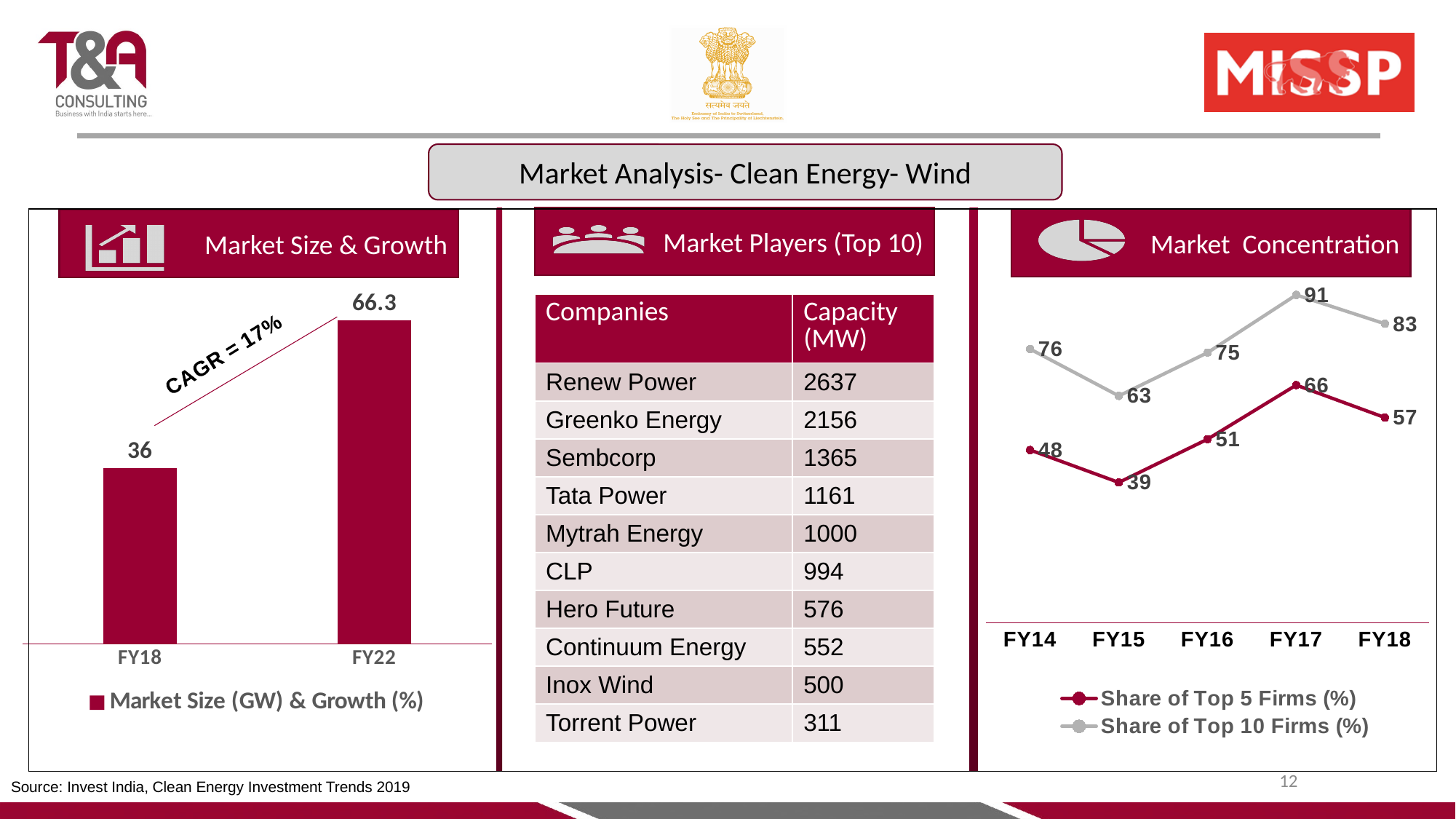
In the Market Concentration chart, what is the Share of Top 10 Firms (%) in FY17? 91 In the Market Concentration chart, in which fiscal year is the Share of Top 10 Firms (%) lowest? FY15 In the Market Size & Growth chart, what is the value for FY18? 36 How many fiscal years are plotted on the x axis of the Market Concentration chart? 5 In the Market Size & Growth chart, what is the value for FY22? 66.3 In the Market Size & Growth chart, what is the difference between the FY22 and FY18 values? 30.3 In the Market Size & Growth chart, what CAGR is annotated between FY18 and FY22? CAGR = 17% In the Market Concentration chart, what is the Share of Top 5 Firms (%) in FY15? 39 In the Market Concentration chart, what is the difference between the Share of Top 10 Firms (%) and the Share of Top 5 Firms (%) in FY18? 26 How many series does the legend of the Market Concentration chart list? 2 What kind of chart is the Market Size & Growth chart? bar chart In the Market Concentration chart, in which fiscal year is the Share of Top 5 Firms (%) highest? FY17